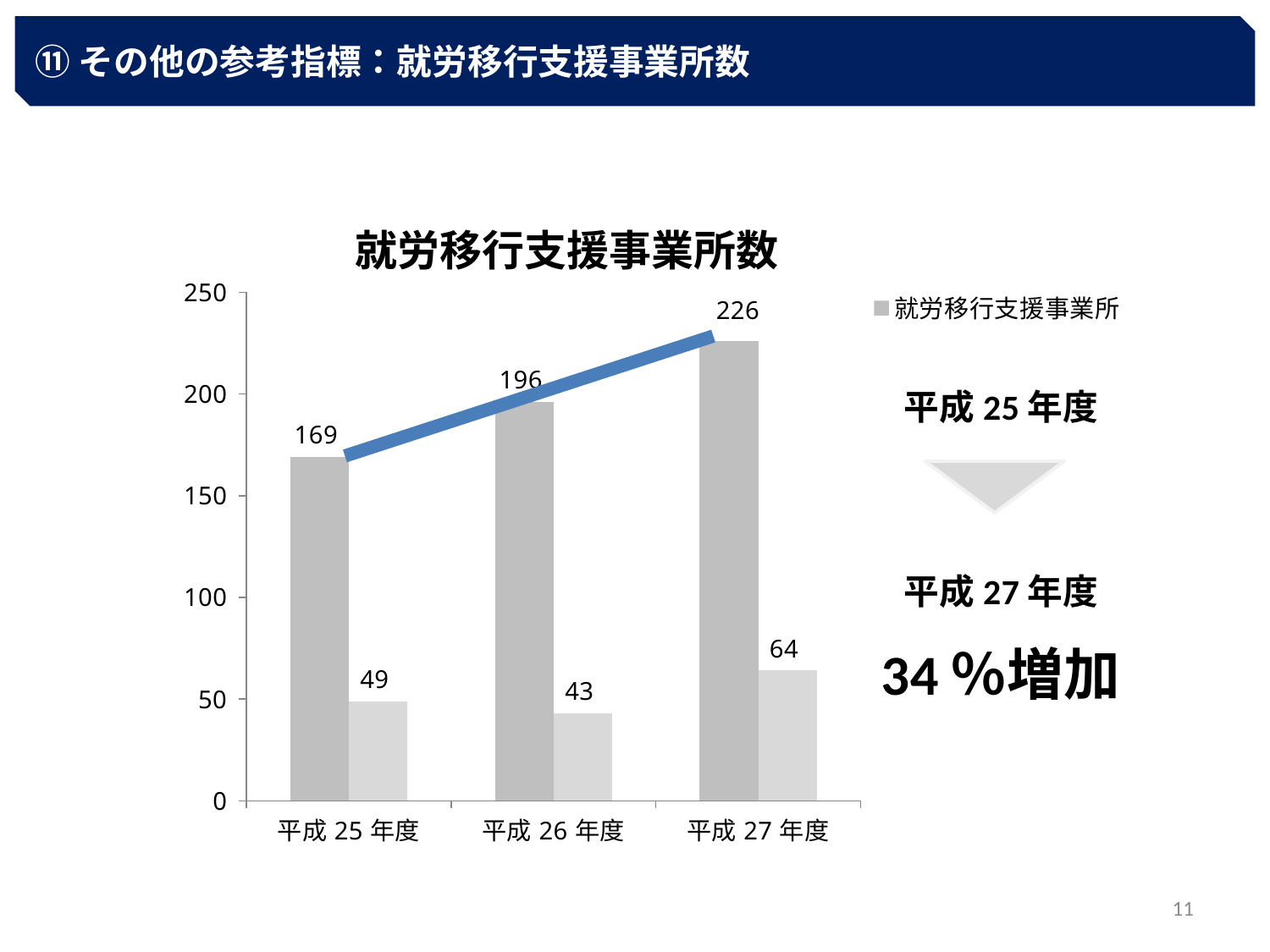
What is the value of the lighter grey bar for 平成 27 年度? 64 What is the value of the 就労移行支援事業所 bar for 平成 27 年度? 226 In which year is the 就労移行支援事業所 value highest? 平成 27 年度 What is the value of the 就労移行支援事業所 bar for 平成 25 年度? 169 What is the value of the lighter grey bar for 平成 26 年度? 43 In which year is the lighter grey bar lowest? 平成 26 年度 How many series does the legend list? 1 Which is larger: the lighter grey bar for 平成 25 年度 or for 平成 27 年度? 平成 27 年度 What is the difference between the 就労移行支援事業所 values for 平成 27 年度 and 平成 25 年度? 57 What kind of chart is shown? Bar chart How many years are shown on the x axis? 3 What is the value of the 就労移行支援事業所 bar for 平成 26 年度? 196